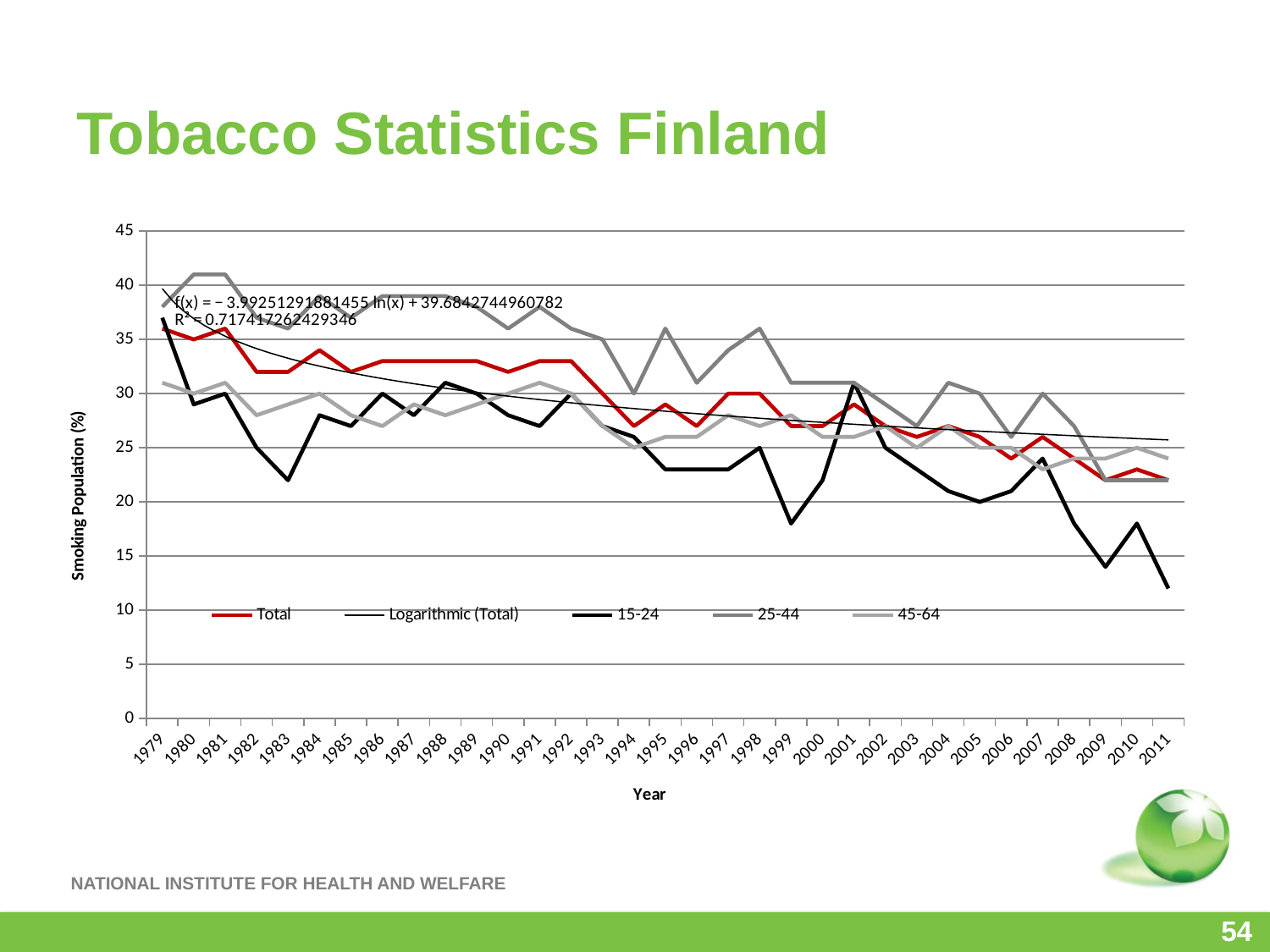
Does the Total series rise or fall overall from 1979 to 2011? fall Is the value for the 15-24 series in 2011 greater or less than 15? less In 1983, which series has the larger value, 25-44 or 15-24? 25-44 How many entries does the chart legend list? 5 Is the value for the 25-44 series in 1980 greater or less than 40? greater What is the title of the y axis? Smoking Population (%) In 2011, which series has the larger value, 45-64 or 15-24? 45-64 What kind of chart is shown on the slide? line chart Is the value for the Total series in 2010 greater or less than 25? less How many years are plotted along the x axis? 33 In which year does the 15-24 series reach its lowest value? 2011